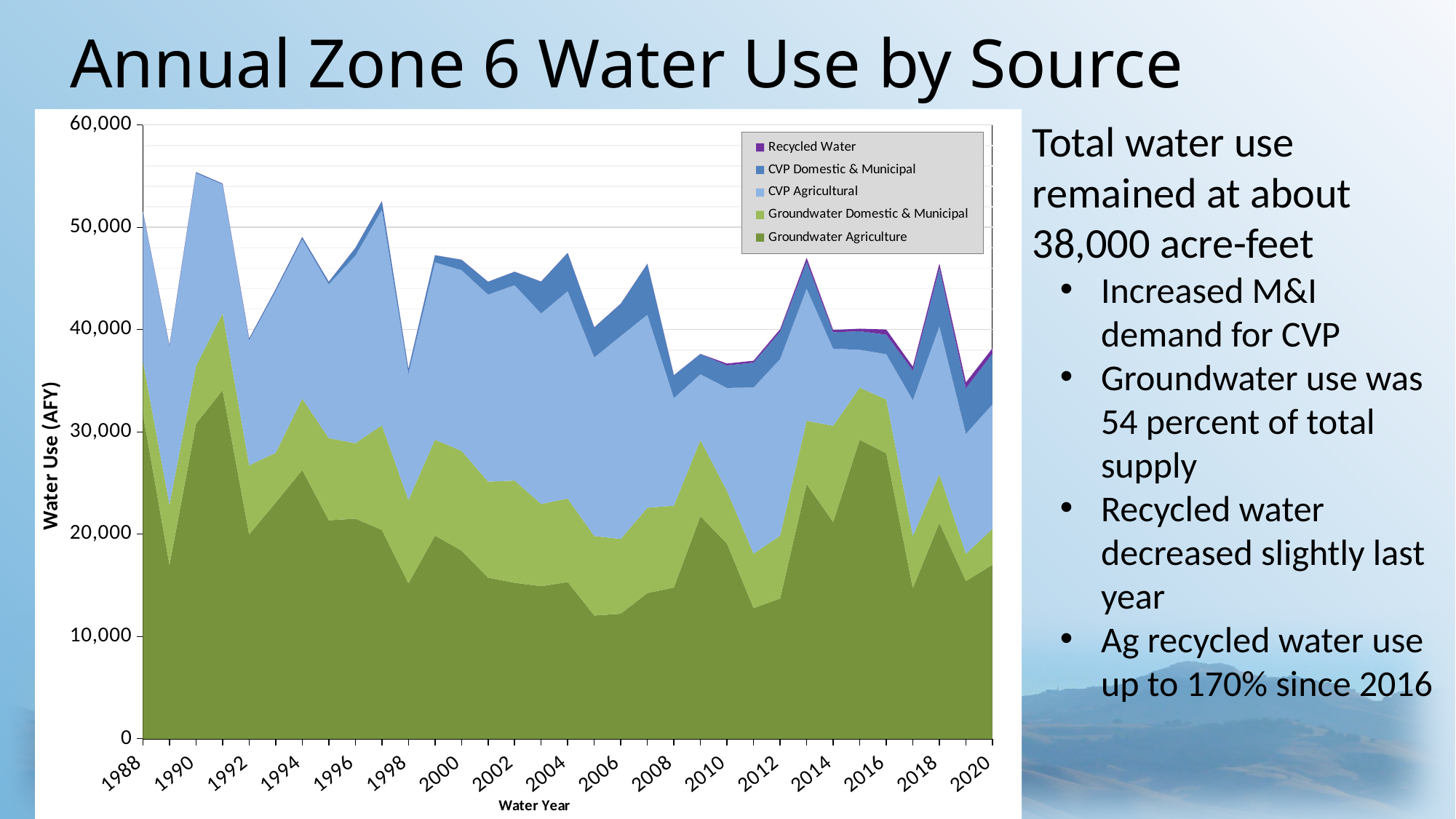
Does the Groundwater Agriculture value rise or fall from 1991 to 2006? fall What kind of chart is shown on the slide? Stacked area chart Which series is listed at the bottom of the legend? Groundwater Agriculture In which year is the total water use highest? 1990 Is the total water use larger in 1991 or in 2020? 1991 Is the total water use in 1991 greater or less than 50,000? greater Is the total water use in 2009 greater or less than 40,000? less How many series does the chart's legend list? 5 Is the total water use in 2020 greater or less than 40,000? less What is the title of the chart's vertical axis? Water Use (AFY)